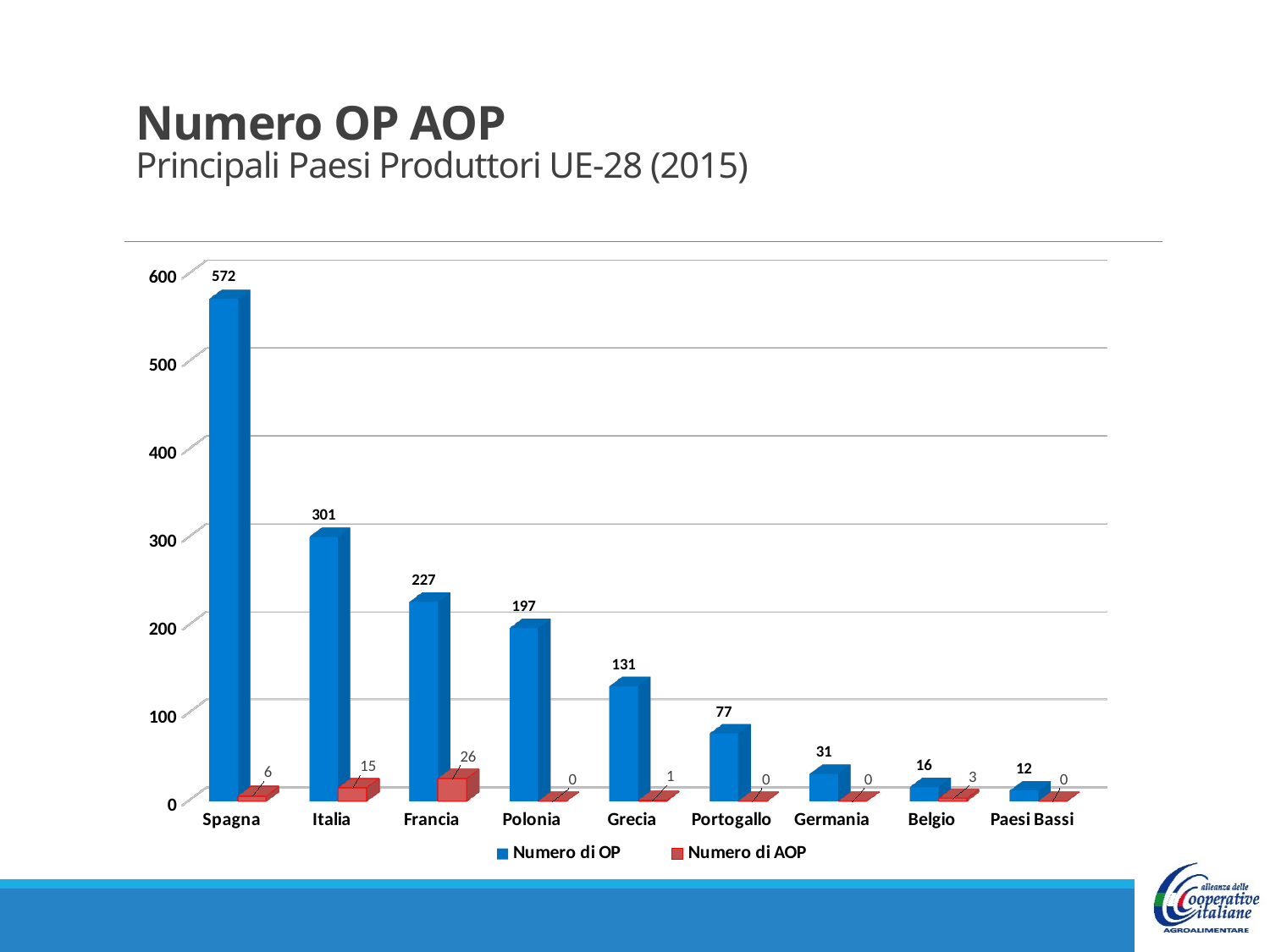
What is the Numero di AOP value for Francia? 26 How many countries are shown on the x axis? 9 What is the Numero di OP value for Spagna? 572 Which country has the highest Numero di OP? Spagna Which country has the highest Numero di AOP? Francia Do the Numero di OP values rise or fall from Spagna to Paesi Bassi along the x axis? Fall Which country has the lowest Numero di OP? Paesi Bassi What is the difference between the Numero di OP for Spagna and Italia? 271 What is the Numero di OP value for Grecia? 131 What kind of chart is shown on the slide? Bar chart How many series does the legend list? 2 Which has a larger Numero di OP, Polonia or Portogallo? Polonia